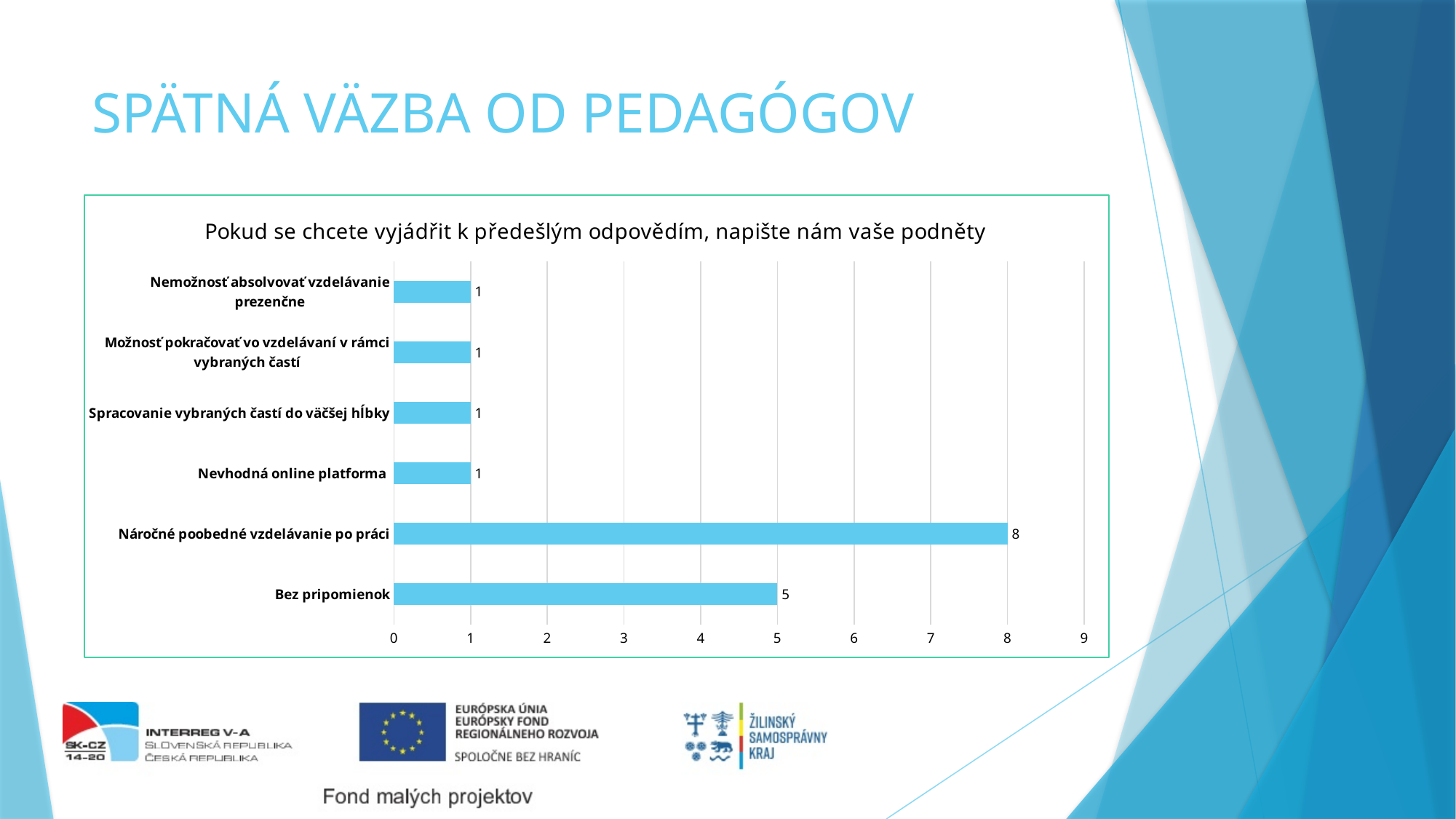
What is the difference between the values for "Náročné poobedné vzdelávanie po práci" and "Bez pripomienok"? 3 What is the title of the chart? Pokud se chcete vyjádřit k předešlým odpovědím, napište nám vaše podněty What value is shown for "Bez pripomienok"? 5 What is the highest value shown on the x axis? 9 Is the value for "Náročné poobedné vzdelávanie po práci" greater or less than 6? greater How many categories are shown in the chart? 6 What kind of chart is shown on the slide? bar chart What value is shown for "Nevhodná online platforma"? 1 How many categories have a value of 1? 4 What value is shown for "Náročné poobedné vzdelávanie po práci"? 8 Which category has the highest value? Náročné poobedné vzdelávanie po práci Which is larger: the value for "Bez pripomienok" or the value for "Nevhodná online platforma"? Bez pripomienok